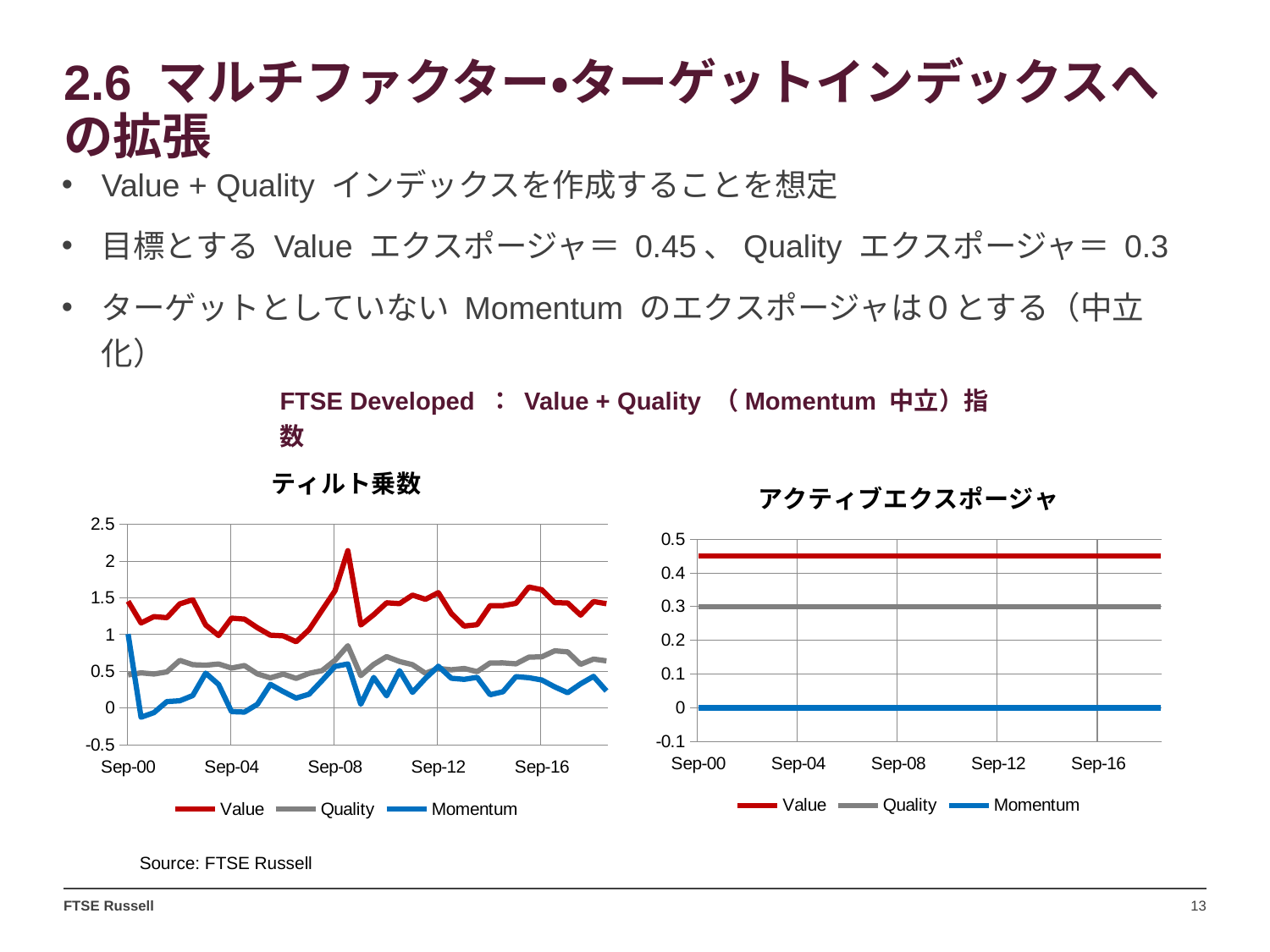
In the right chart (アクティブエクスポージャ), what is the value of the Quality line? 0.3 In the left chart (ティルト乗数), which series has the highest values across the period? Value What kind of chart is the left chart titled ティルト乗数? line chart What are the legend entries of the left chart (ティルト乗数)? Value, Quality, Momentum How many series does the legend of the right chart (アクティブエクスポージャ) list? 3 In the left chart (ティルト乗数), which series is larger at Sep-04, Value or Momentum? Value In the right chart (アクティブエクスポージャ), which series has the lowest exposure? Momentum In the left chart (ティルト乗数), is the peak of the Value line near Sep-08 greater or less than 2? greater In the right chart (アクティブエクスポージャ), is the value of the Value line greater or less than 0.4? greater In the right chart (アクティブエクスポージャ), which series has the highest exposure? Value In the left chart (ティルト乗数), does the Momentum line rise or fall between Sep-00 and the first point after it? fall In the right chart (アクティブエクスポージャ), what is the value of the Momentum line? 0